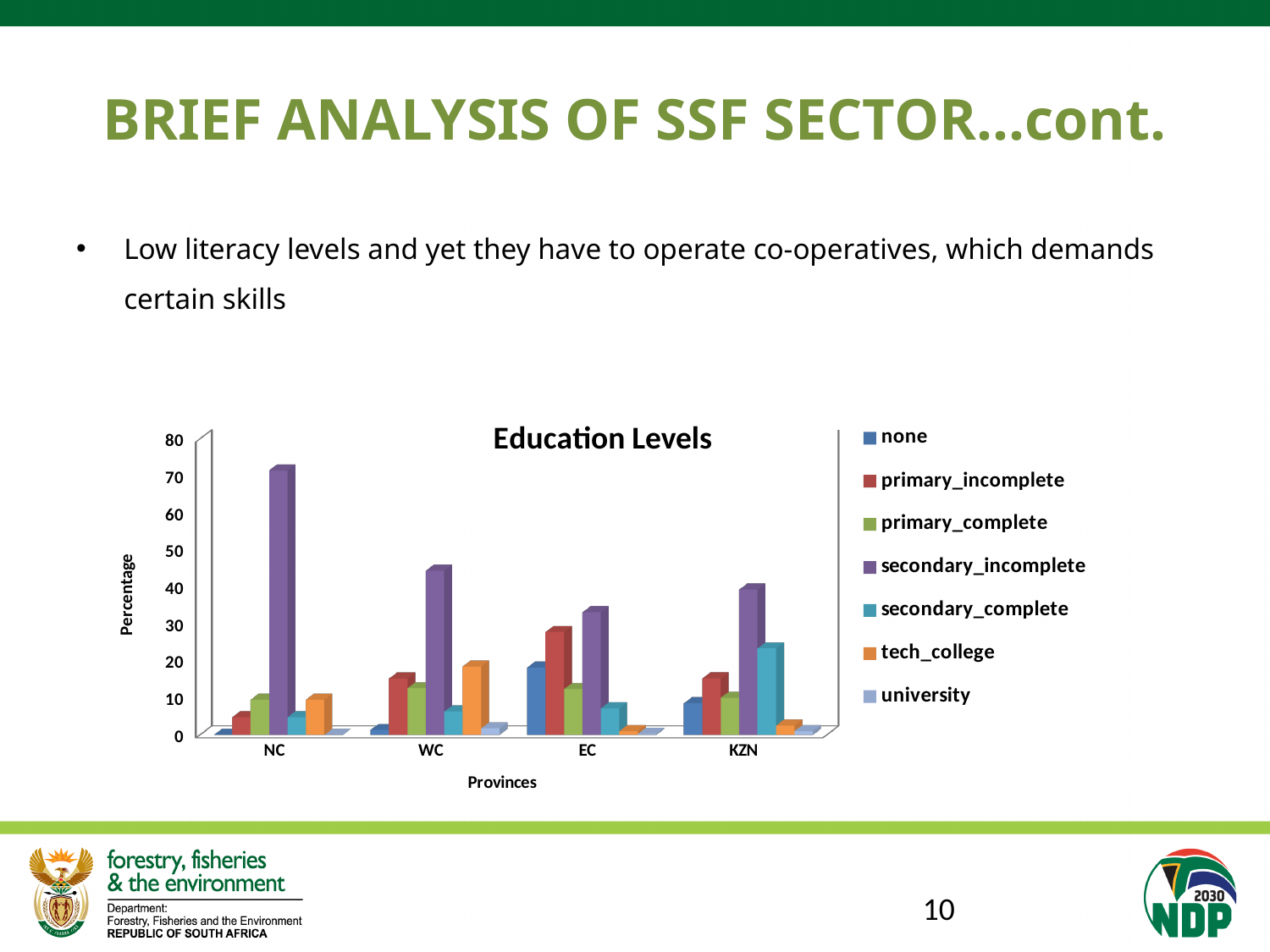
What kind of chart is shown on the slide? bar chart How many provinces are shown on the x axis of the chart? 4 Which province has a larger value for none, EC or KZN? EC Is the value for primary_incomplete in EC greater or less than 20? greater What is the title of the chart? Education Levels Is the value for secondary_complete in KZN greater or less than 10? greater Which province has the highest value for tech_college? WC Is the value for secondary_incomplete in NC greater or less than 60? greater What is the label of the vertical axis? Percentage Which province has the highest value for secondary_incomplete? NC How many series does the chart's legend list? 7